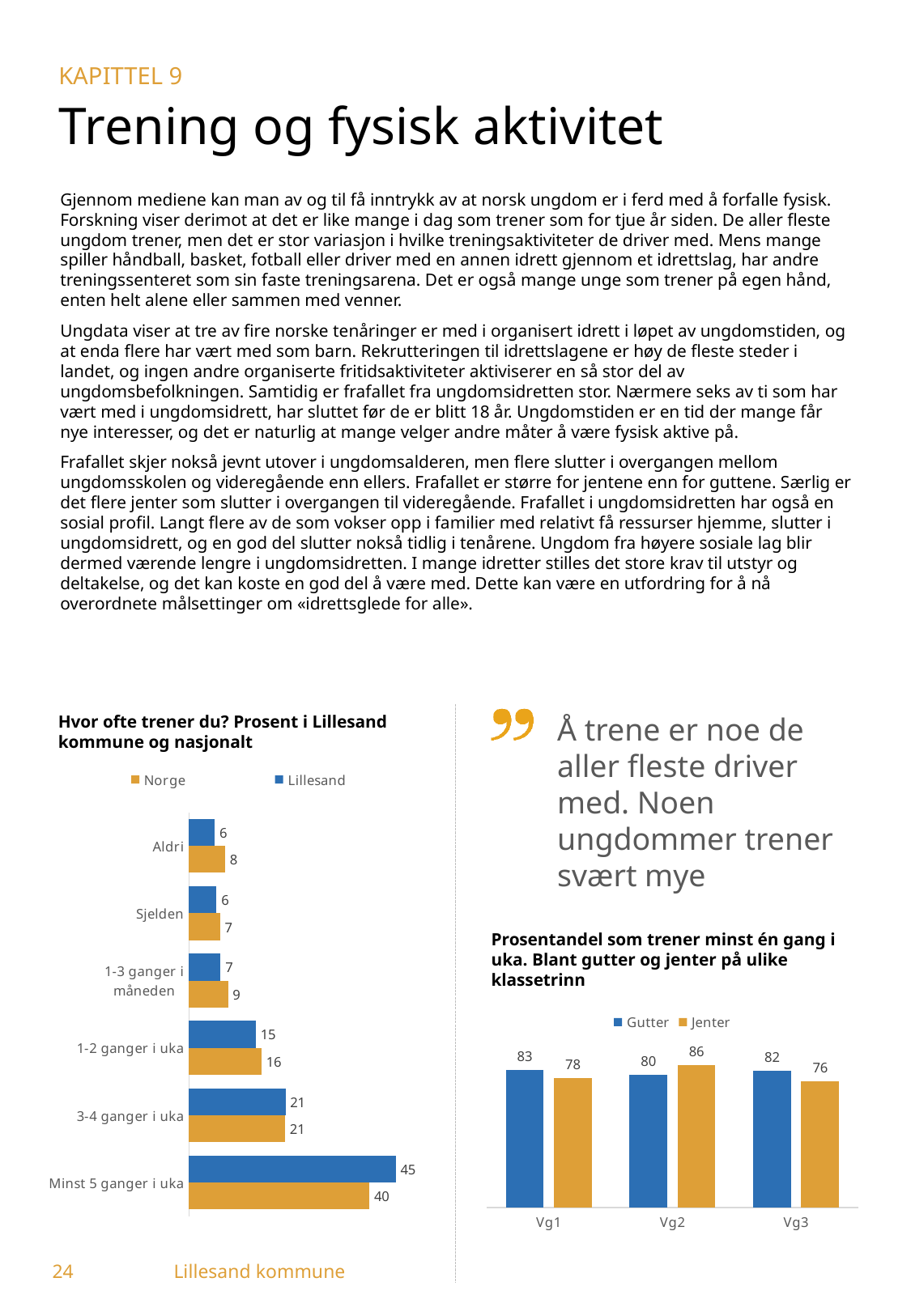
In the chart 'Hvor ofte trener du? Prosent i Lillesand kommune og nasjonalt', which category has the highest value for Lillesand? Minst 5 ganger i uka In the chart 'Hvor ofte trener du? Prosent i Lillesand kommune og nasjonalt', how many categories are shown? 6 In the chart 'Prosentandel som trener minst én gang i uka', which colour represents Gutter? Blue In the chart 'Prosentandel som trener minst én gang i uka', what is the difference between Gutter and Jenter at Vg1? 5 In the chart 'Hvor ofte trener du? Prosent i Lillesand kommune og nasjonalt', what is the difference between Lillesand and Norge for 'Minst 5 ganger i uka'? 5 In the chart 'Hvor ofte trener du? Prosent i Lillesand kommune og nasjonalt', how many series does the legend list? 2 What kind of chart is 'Hvor ofte trener du? Prosent i Lillesand kommune og nasjonalt'? Bar chart In the chart 'Prosentandel som trener minst én gang i uka', which class level has the lowest value for Jenter? Vg3 In the chart 'Hvor ofte trener du? Prosent i Lillesand kommune og nasjonalt', what is the value for Norge for 'Aldri'? 8 In the chart 'Hvor ofte trener du? Prosent i Lillesand kommune og nasjonalt', what is the value for Lillesand for 'Minst 5 ganger i uka'? 45 In the chart 'Prosentandel som trener minst én gang i uka', what is the value for Jenter at Vg2? 86 In the chart 'Prosentandel som trener minst én gang i uka', which is larger at Vg3, Gutter or Jenter? Gutter